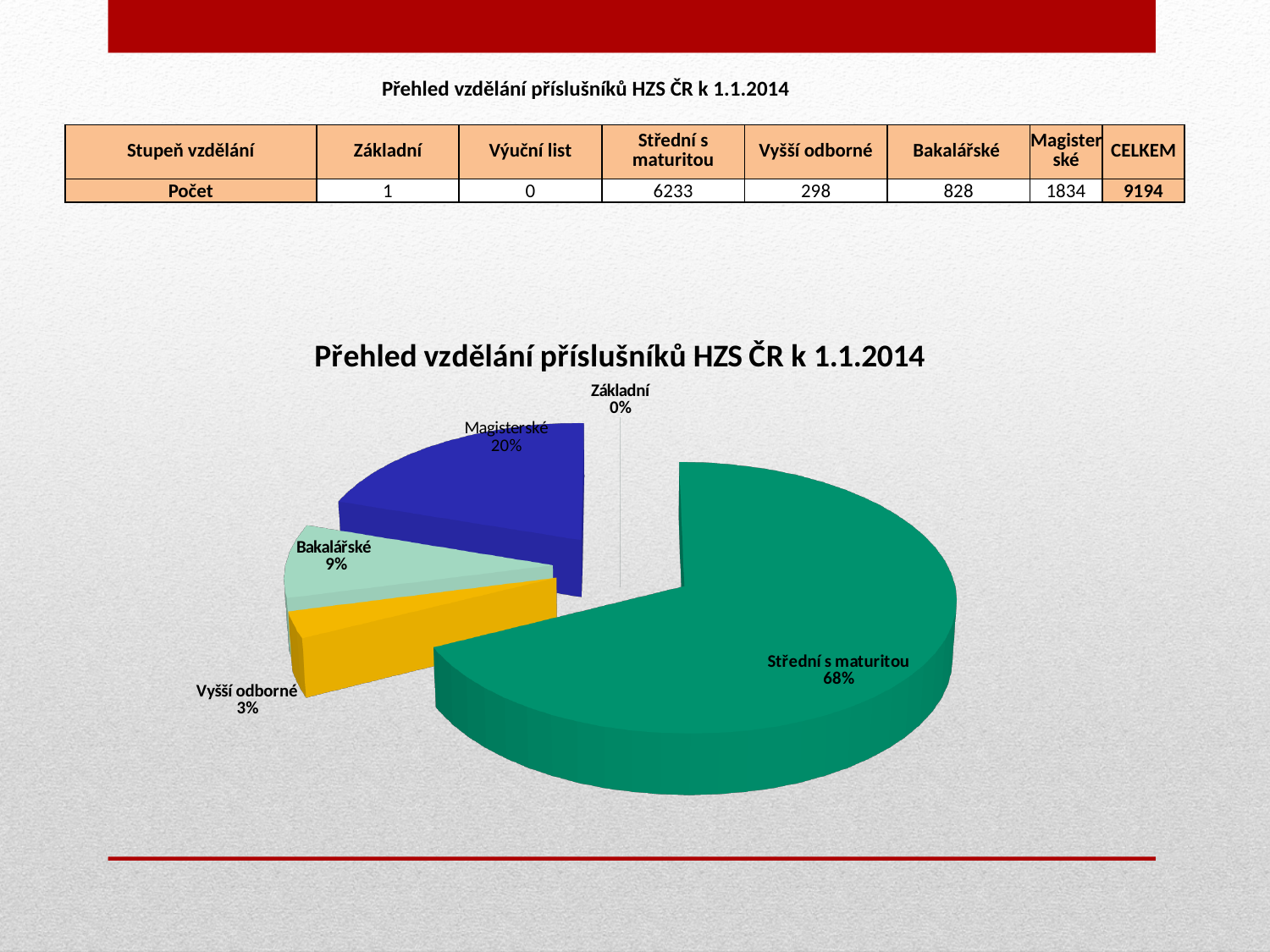
What share of the pie does Magisterské represent? 20% What share of the pie does Vyšší odborné represent? 3% What share of the pie does Střední s maturitou represent? 68% What type of chart is shown on the slide? pie chart Which slice is larger, Magisterské or Bakalářské? Magisterské What is the title of the chart? Přehled vzdělání příslušníků HZS ČR k 1.1.2014 How many labelled categories are shown in the pie chart? 5 Which labelled category has the smallest share of the pie? Základní Which category has the largest slice of the pie? Střední s maturitou What is the difference in percentage points between the Střední s maturitou and Magisterské slices? 48 What percentage is shown for Základní in the pie chart? 0%